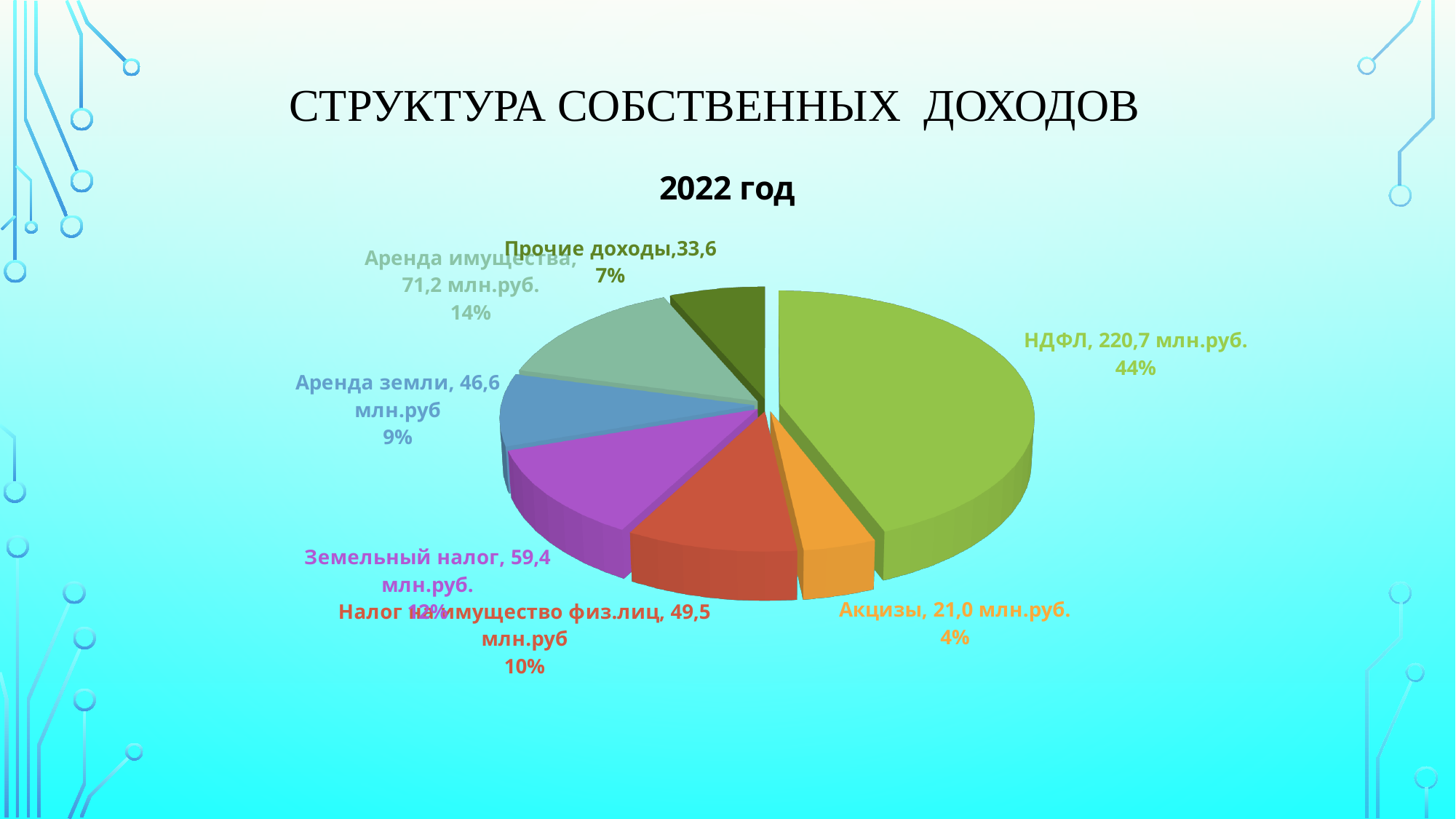
What is the difference between the values for Аренда имущества and Аренда земли? 24,6 млн.руб. What share of the pie does Аренда имущества take? 14% Which category has the smallest slice? Акцизы What is the value for Аренда земли? 46,6 млн.руб What is the value for НДФЛ? 220,7 млн.руб. What is the chart's title? 2022 год What kind of chart is shown on the slide? pie chart How many slices does the pie chart have? 7 Which category has the largest slice? НДФЛ What share of the pie does НДФЛ take? 44% Which is larger, Земельный налог or Налог на имущество физ.лиц? Земельный налог What is the value for Акцизы? 21,0 млн.руб.